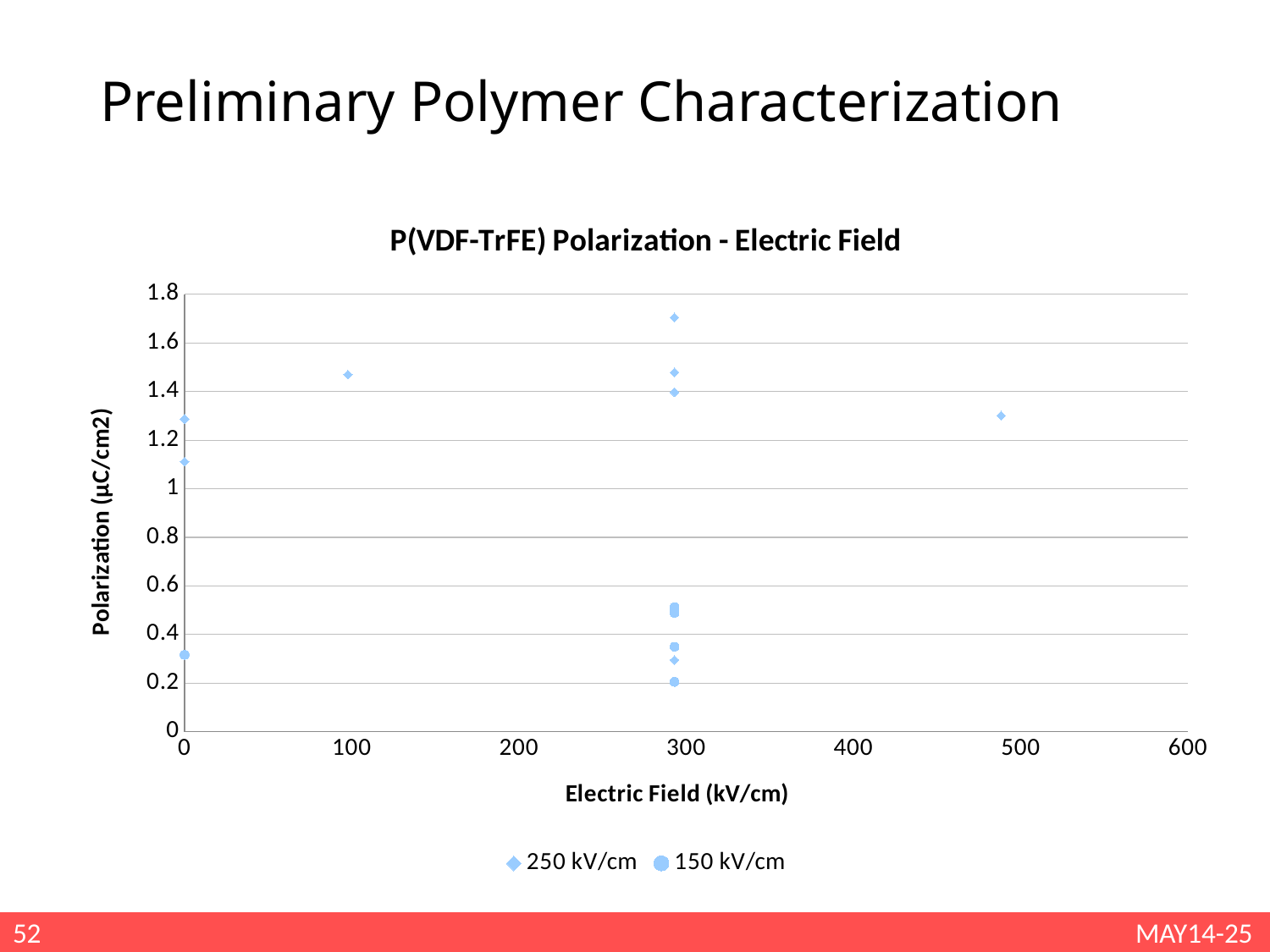
What is the label of the y axis? Polarization (µC/cm2) Is the 250 kV/cm point at an electric field of 100 kV/cm greater or less than 1.4? greater Which series contains the highest plotted point? 250 kV/cm How many series does the legend list? 2 Are all the 150 kV/cm points greater or less than 0.6? less Which is larger: the 250 kV/cm point at 100 kV/cm or the 250 kV/cm point near 490 kV/cm? the point at 100 kV/cm What is the title of the chart? P(VDF-TrFE) Polarization - Electric Field Is the 250 kV/cm point near 490 kV/cm greater or less than 1.2? greater What kind of chart is shown on the slide? scatter chart Which series contains the lowest plotted point? 150 kV/cm